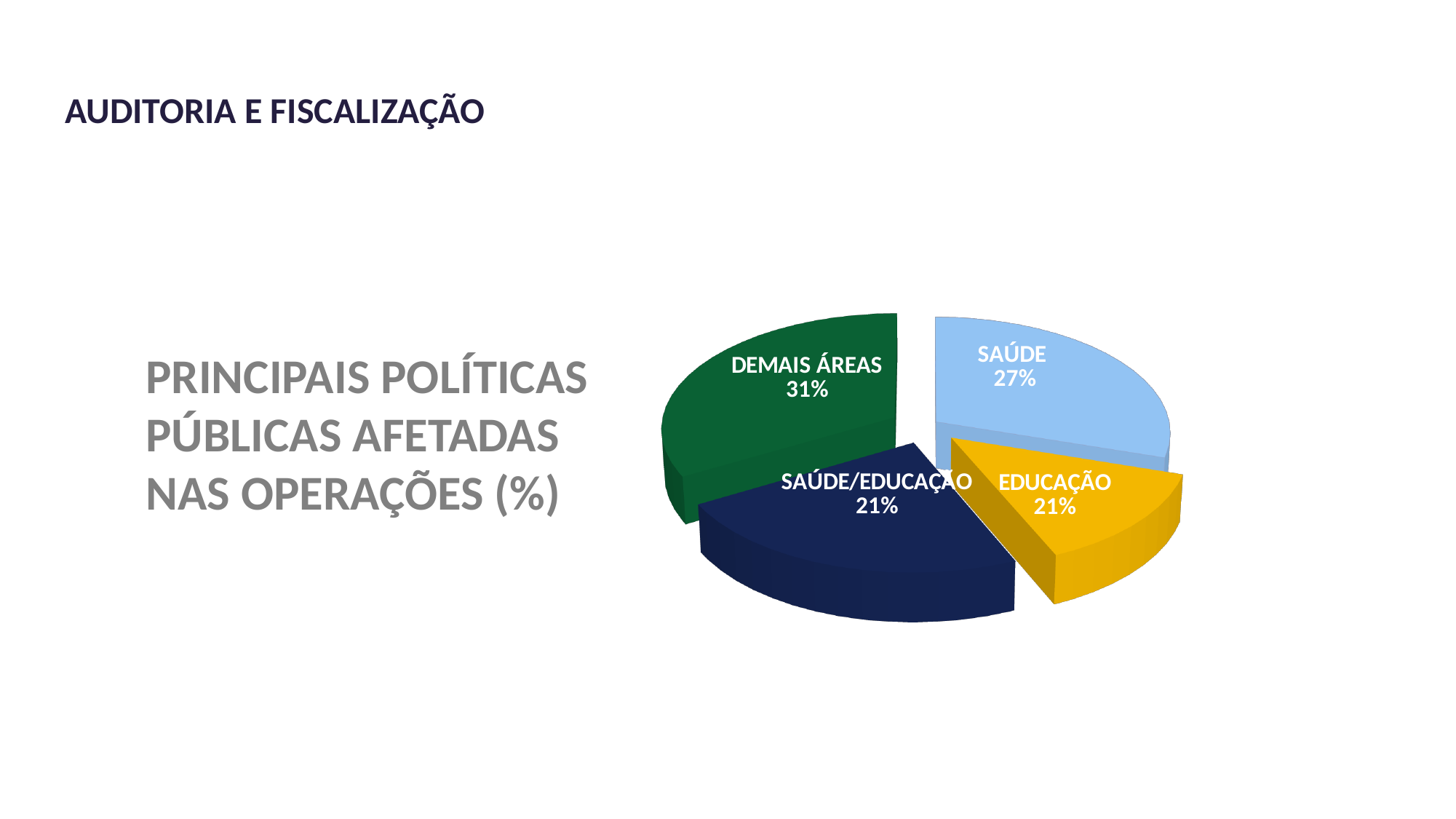
How many slices does the pie chart have? 4 What colour is the DEMAIS ÁREAS slice? Green What is the difference in percentage points between DEMAIS ÁREAS and SAÚDE? 4 What percentage does the SAÚDE/EDUCAÇÃO slice represent? 21% What percentage does the EDUCAÇÃO slice represent? 21% What percentage does the SAÚDE slice represent? 27% What type of chart is shown on the slide? Pie chart Which is larger, the SAÚDE slice or the EDUCAÇÃO slice? SAÚDE What is the title of the pie chart? PRINCIPAIS POLÍTICAS PÚBLICAS AFETADAS NAS OPERAÇÕES (%) What is the difference in percentage points between SAÚDE and EDUCAÇÃO? 6 Which slice has the largest share of the pie? DEMAIS ÁREAS What percentage does the DEMAIS ÁREAS slice represent? 31%